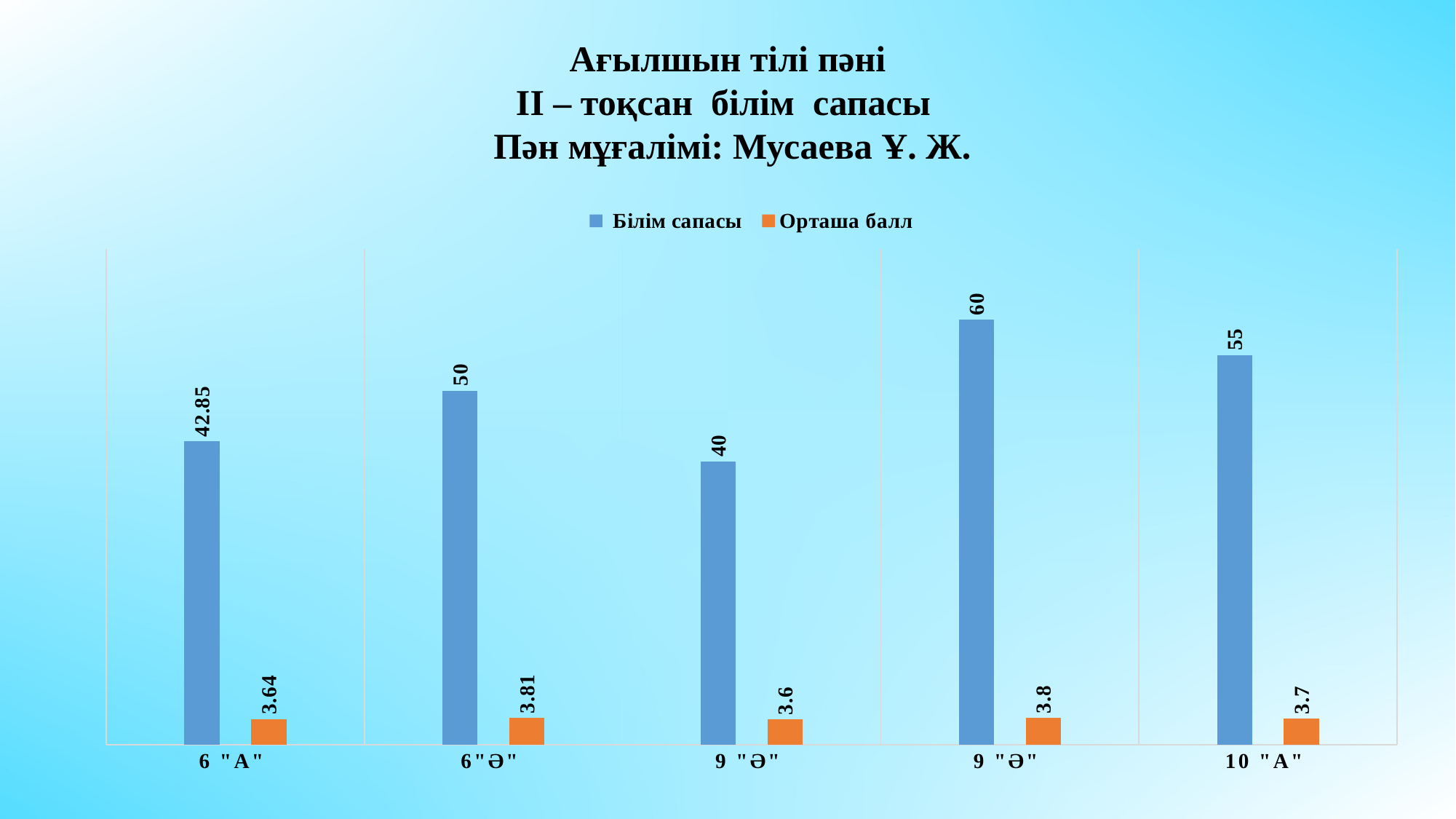
What is the Орташа балл value for 6"Ә"? 3.81 What is the highest Білім сапасы value shown on the chart? 60 Which has the larger Білім сапасы value, 6"Ә" or 10 "А"? 10 "А" What is the Білім сапасы value for 10 "А"? 55 What kind of chart is shown on the slide? Bar chart How many class categories are shown on the x axis? 5 How many series does the legend list? 2 What is the Орташа балл value for 10 "А"? 3.7 What is the difference between the Білім сапасы values for 10 "А" and 6 "А"? 12.15 What is the lowest Білім сапасы value shown on the chart? 40 What is the Білім сапасы value for 6 "А"? 42.85 Which series is shown in orange according to the legend? Орташа балл